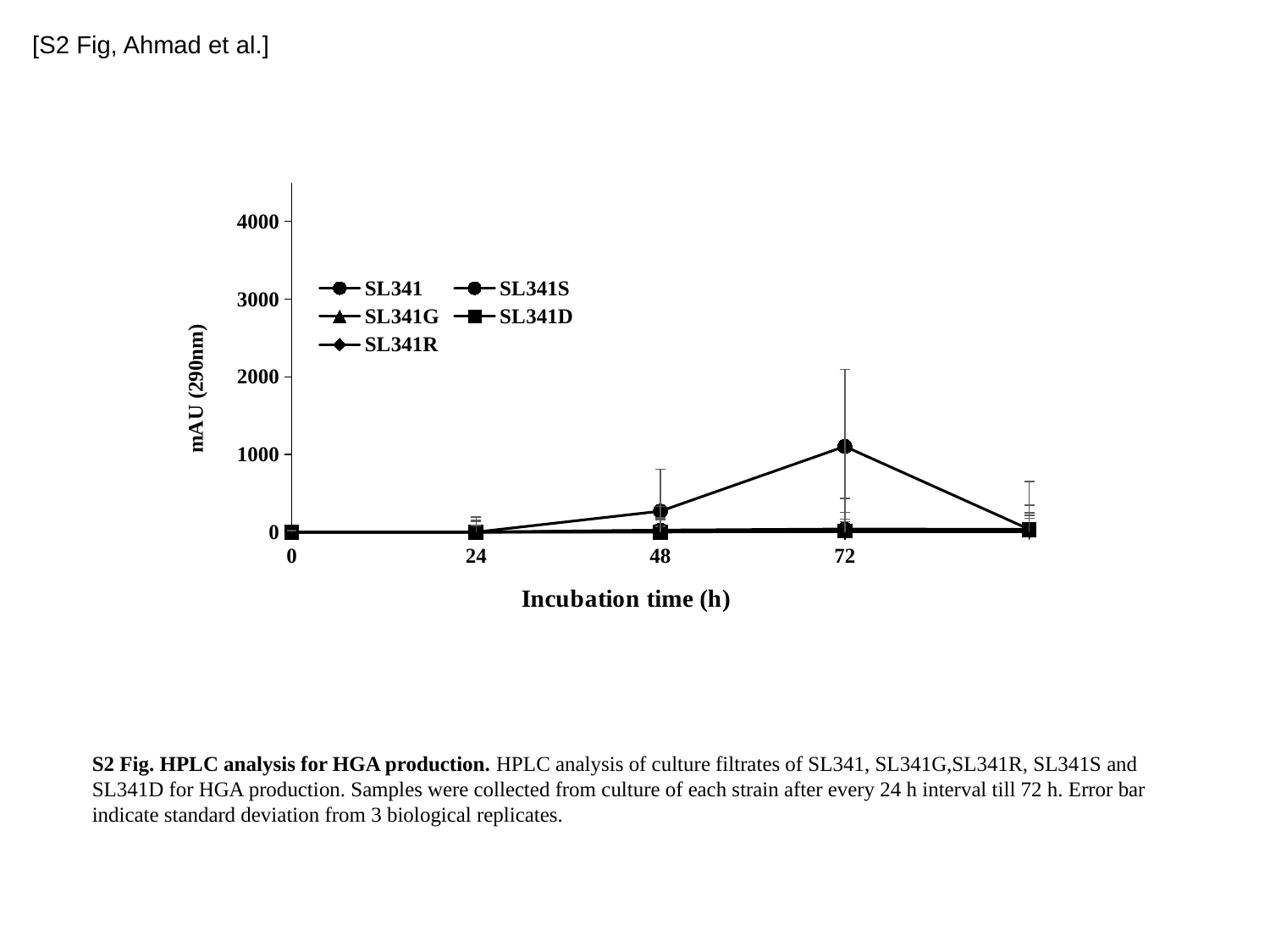
Is the value for SL341 at 72 h greater or less than 1000? greater How many series does the legend list? 5 Is the value for SL341 at 48 h greater or less than 1000? less Is the value for SL341 at 72 h greater or less than 2000? less What is the label of the x axis? Incubation time (h) Which series has the highest value at 72 h? SL341 Which is larger at 72 h, the value for SL341 or the value for SL341D? SL341 What is the label of the y axis? mAU (290nm) Does the SL341 line rise or fall after 72 h? fall Does the SL341 line rise or fall between 48 h and 72 h? rise What is the highest value labeled on the y axis? 4000 What kind of chart is shown on the slide? line chart